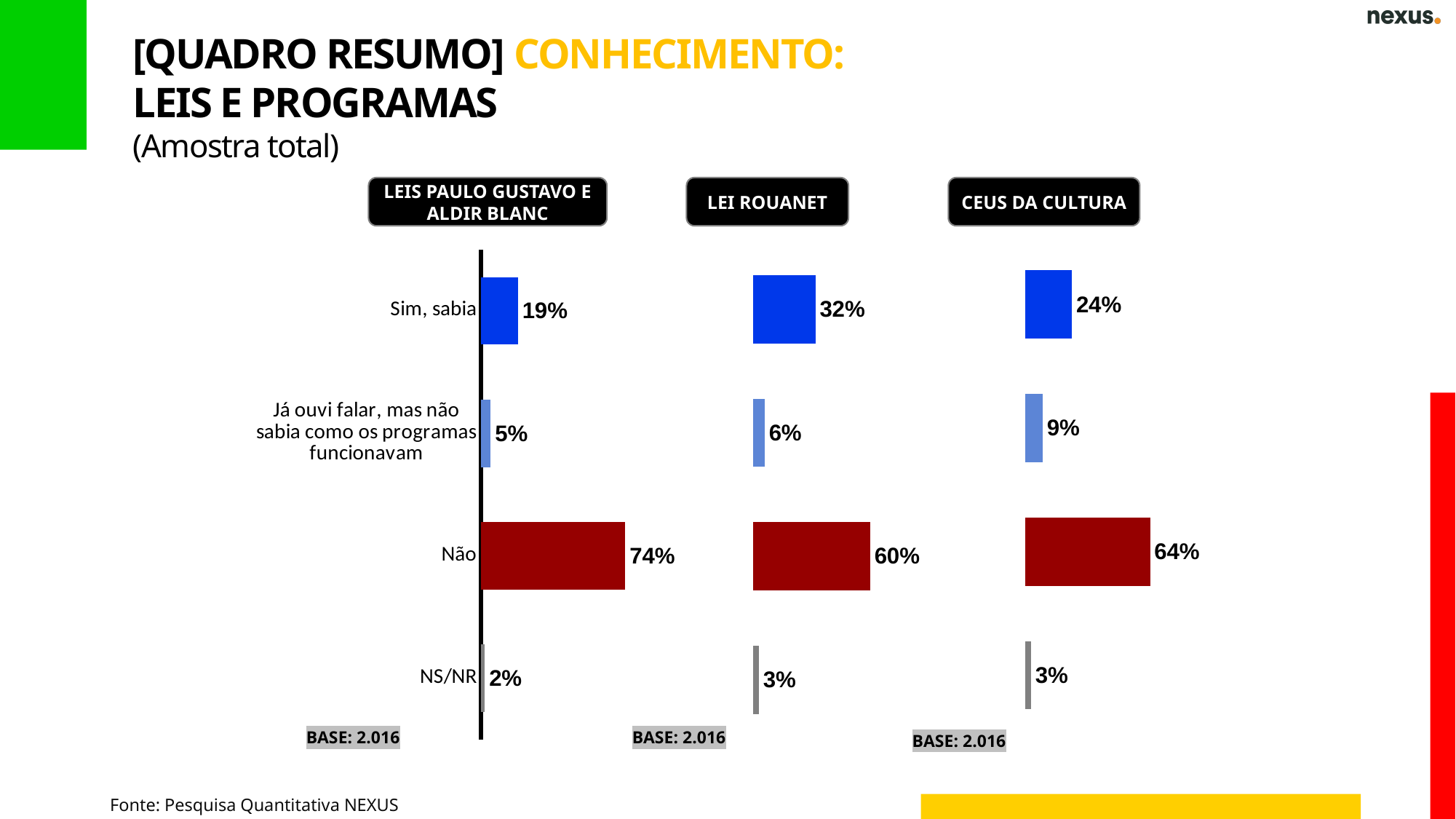
In the LEI ROUANET chart, what is the value for "Não"? 60% In the LEI ROUANET chart, what is the difference between "Não" and "Sim, sabia"? 28 percentage points In the LEIS PAULO GUSTAVO E ALDIR BLANC chart, what is the value for "Sim, sabia"? 19% In the CEUS DA CULTURA chart, which category has the highest value? Não What is the difference between "Não" in the LEIS PAULO GUSTAVO E ALDIR BLANC chart and "Não" in the CEUS DA CULTURA chart? 10 percentage points In the CEUS DA CULTURA chart, what is the value for "Já ouvi falar, mas não sabia como os programas funcionavam"? 9% In the LEI ROUANET chart, what is the value for NS/NR? 3% In the LEIS PAULO GUSTAVO E ALDIR BLANC chart, which category has the lowest value? NS/NR Which is larger: "Sim, sabia" in the LEI ROUANET chart or "Sim, sabia" in the CEUS DA CULTURA chart? LEI ROUANET What base (sample size) is shown under each chart? 2.016 How many categories does each chart show? 4 What kind of chart is used for LEIS PAULO GUSTAVO E ALDIR BLANC? Bar chart